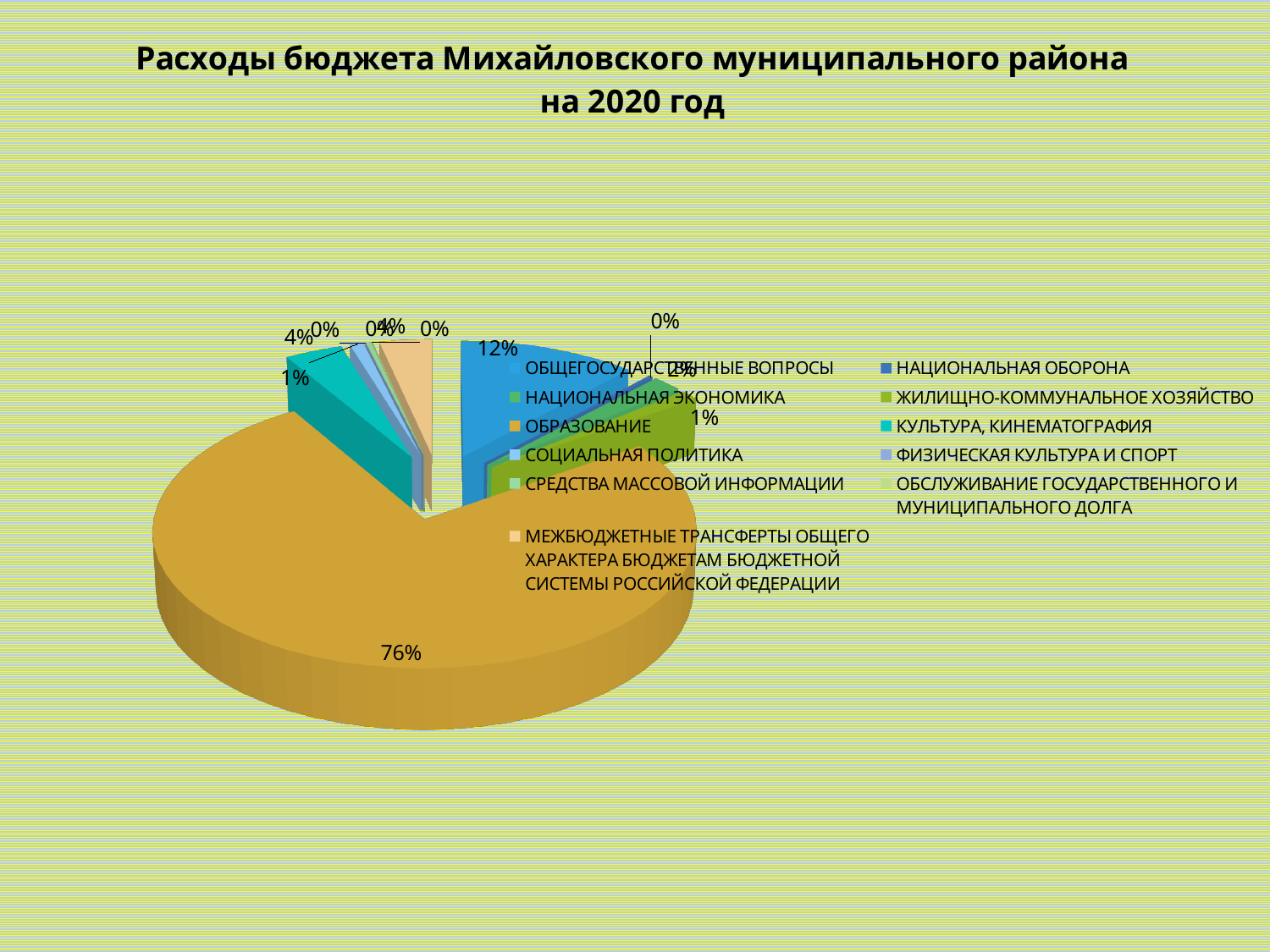
What share of the pie does ОБЩЕГОСУДАРСТВЕННЫЕ ВОПРОСЫ account for? 12% What share of the pie does ОБРАЗОВАНИЕ account for? 76% Which is larger: the slice for ОБРАЗОВАНИЕ or the slice for ОБЩЕГОСУДАРСТВЕННЫЕ ВОПРОСЫ? ОБРАЗОВАНИЕ By how many percentage points does the ОБРАЗОВАНИЕ share exceed the ОБЩЕГОСУДАРСТВЕННЫЕ ВОПРОСЫ share? 64 percentage points How many categories does the legend list? 11 What colour is the ОБРАЗОВАНИЕ slice? Orange Which category has the largest slice of the pie? ОБРАЗОВАНИЕ What is the title of the chart on the slide? Расходы бюджета Михайловского муниципального района на 2020 год Is the share for ОБРАЗОВАНИЕ greater or less than 50%? greater What kind of chart is shown on the slide? Pie chart